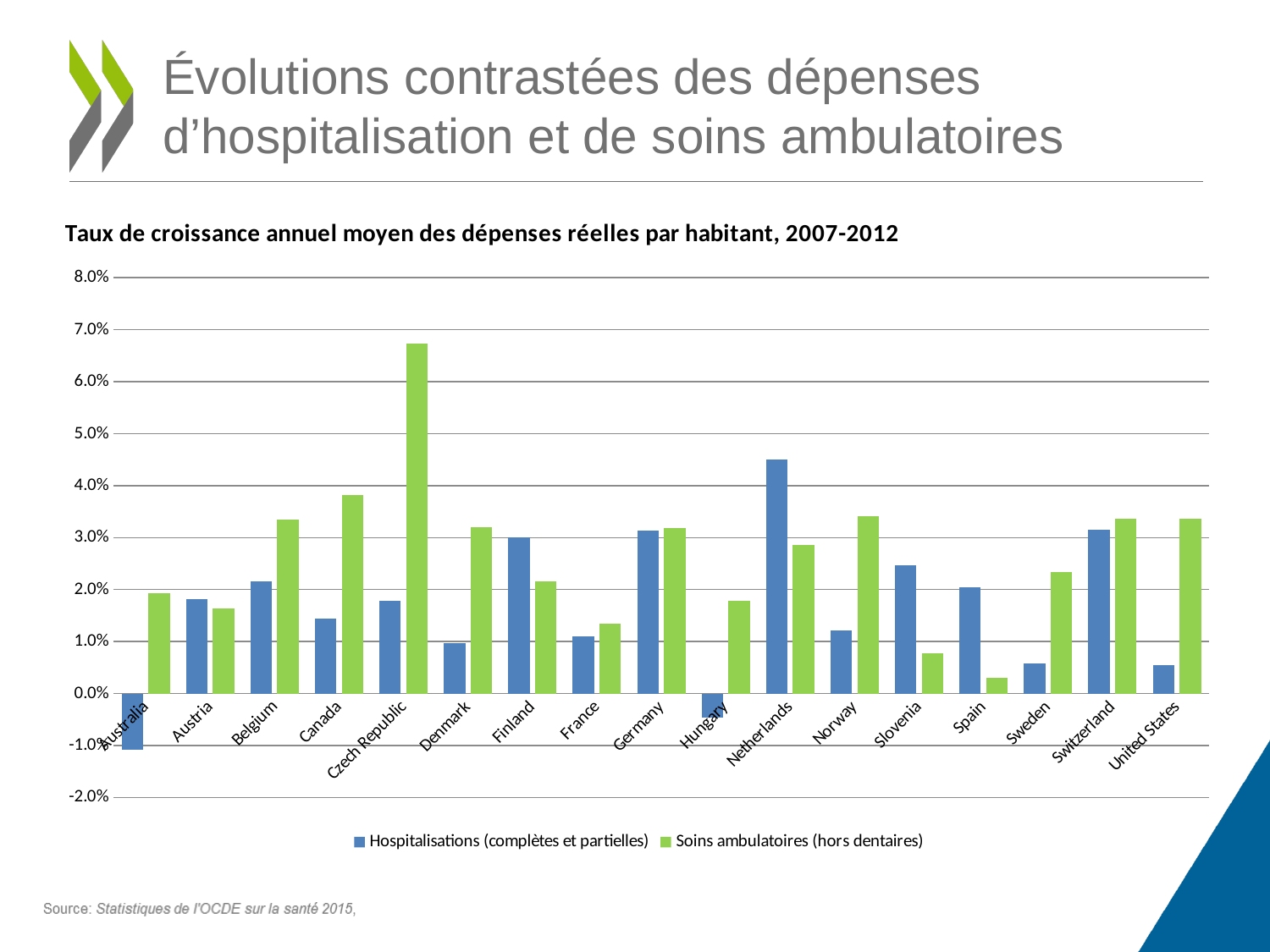
Which country has the highest value for Soins ambulatoires (hors dentaires)? Czech Republic Which country has the lowest value for Hospitalisations (complètes et partielles)? Australia Which country has the lowest value for Soins ambulatoires (hors dentaires)? Spain How many series does the legend list? 2 Is the value for Hospitalisations in the Netherlands greater or less than 4.0%? greater What is the title of the chart? Taux de croissance annuel moyen des dépenses réelles par habitant, 2007-2012 What kind of chart is shown on the slide? Bar chart Is the value for Soins ambulatoires in the Czech Republic greater or less than 6.0%? greater How many countries are shown on the x axis? 17 For Slovenia, which series has the larger value: Hospitalisations or Soins ambulatoires? Hospitalisations (complètes et partielles) Which country has the highest value for Hospitalisations (complètes et partielles)? Netherlands Is the value for Hospitalisations in Hungary greater or less than 0.0%? less